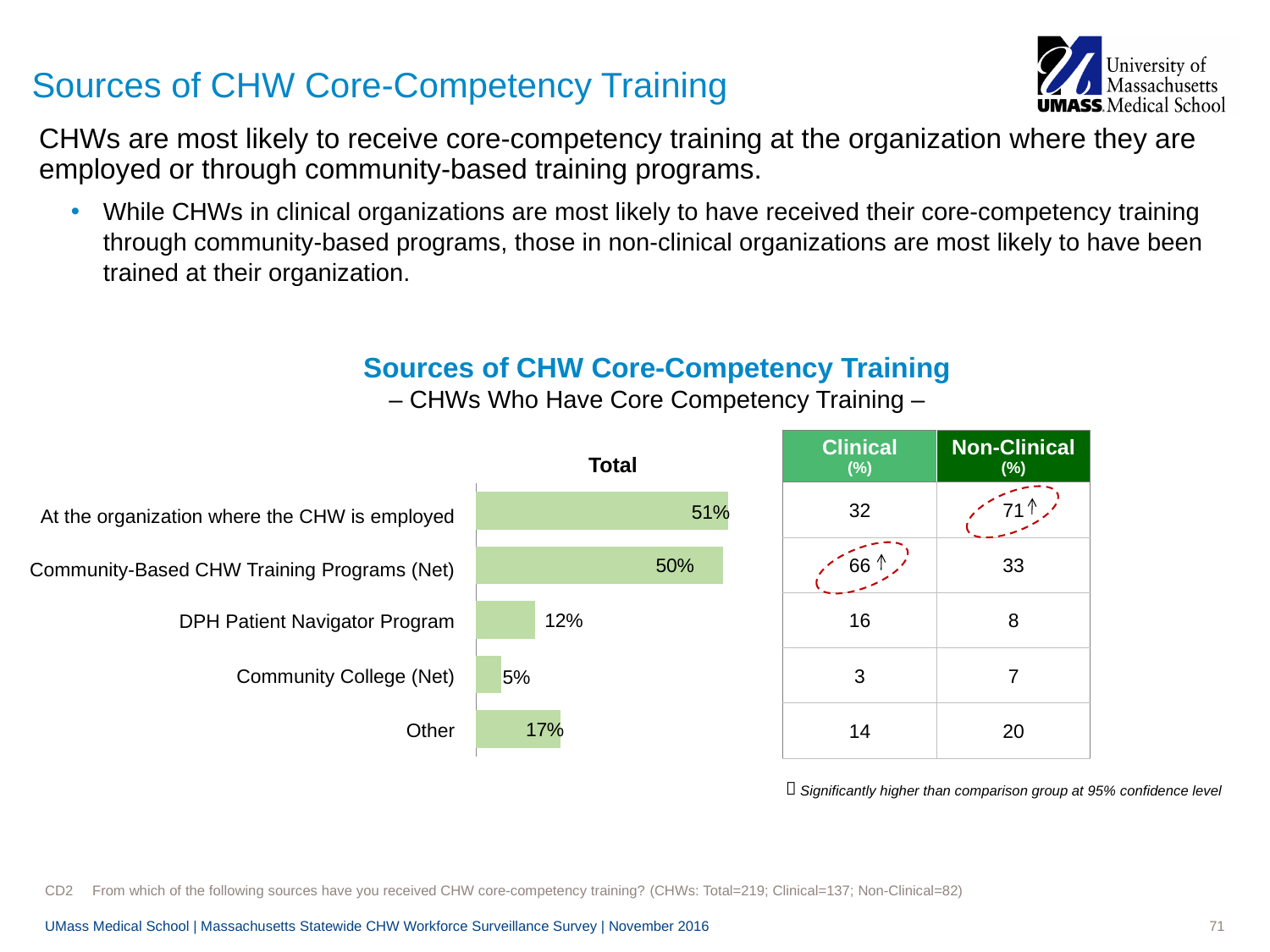
What is the difference in Total value between 'Other' and 'DPH Patient Navigator Program'? 5% What is the title of the chart? Sources of CHW Core-Competency Training What is the Total value for 'DPH Patient Navigator Program'? 12% What is the Total value for 'At the organization where the CHW is employed'? 51% What is the Total value for 'Community-Based CHW Training Programs (Net)'? 50% Which category has the highest Total value? At the organization where the CHW is employed Which category has the lowest Total value? Community College (Net) How many categories are shown in the bar chart? 5 What kind of chart is used to show the Total values? Bar chart What is the Total value for 'Other'? 17% What is the Total value for 'Community College (Net)'? 5% Which has a larger Total value, 'Other' or 'DPH Patient Navigator Program'? Other